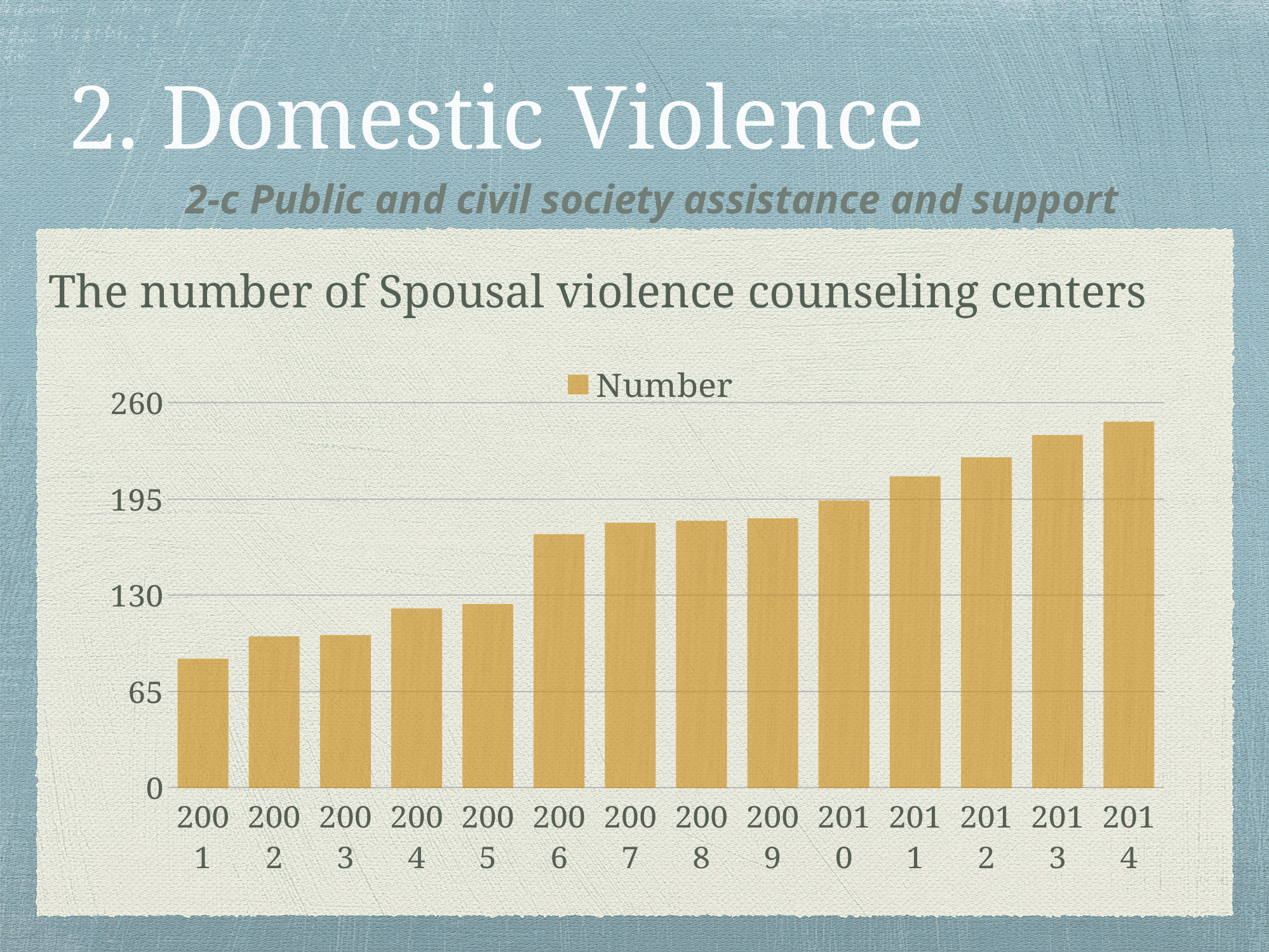
What is the title of the chart? The number of Spousal violence counseling centers Do the values generally rise or fall from 2001 to 2014? rise Which year has the larger value, 2005 or 2006? 2006 How many years are plotted on the x axis of the chart? 14 What is the name of the series shown in the legend? Number Which year has the highest number of spousal violence counseling centers? 2014 Is the value for 2014 greater or less than 195? greater Is the value for 2001 greater or less than 130? less How many series does the chart's legend list? 1 Which year has the lowest number of spousal violence counseling centers? 2001 What kind of chart is shown on the slide? bar chart Is the value for 2006 greater or less than 130? greater